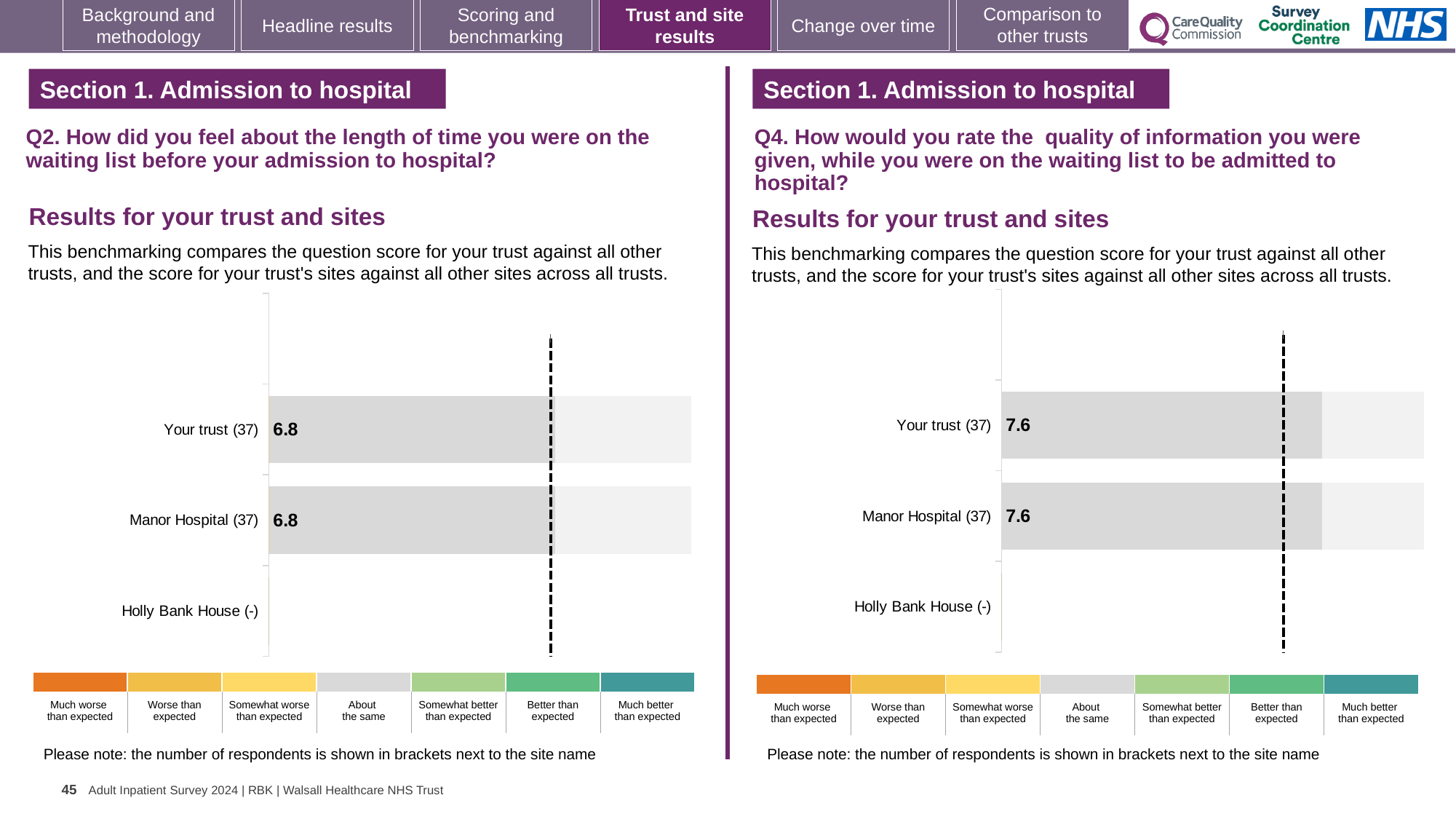
On the right chart (Q4), what is the score for Manor Hospital? 7.6 On the left chart (Q2), how many respondents are shown in brackets for Your trust? 37 What kind of chart is used on the left (Q2) to show the results for your trust and sites? Bar chart On the left chart (Q2), what is the score for Your trust? 6.8 On the right chart (Q4), which site has no score shown? Holly Bank House On the left chart (Q2), how many sites or categories are listed on the vertical axis? 3 On the right chart (Q4), what is the score for Your trust? 7.6 On the left chart (Q2), what is the score for Manor Hospital? 6.8 On the right chart (Q4), how many sites or categories are listed on the vertical axis? 3 On the right chart (Q4), what is the difference between the score for Your trust and the score for Manor Hospital? 0 On the left chart (Q2), how many respondents are shown in brackets for Manor Hospital? 37 On the left chart (Q2), what is the difference between the score for Your trust and the score for Manor Hospital? 0